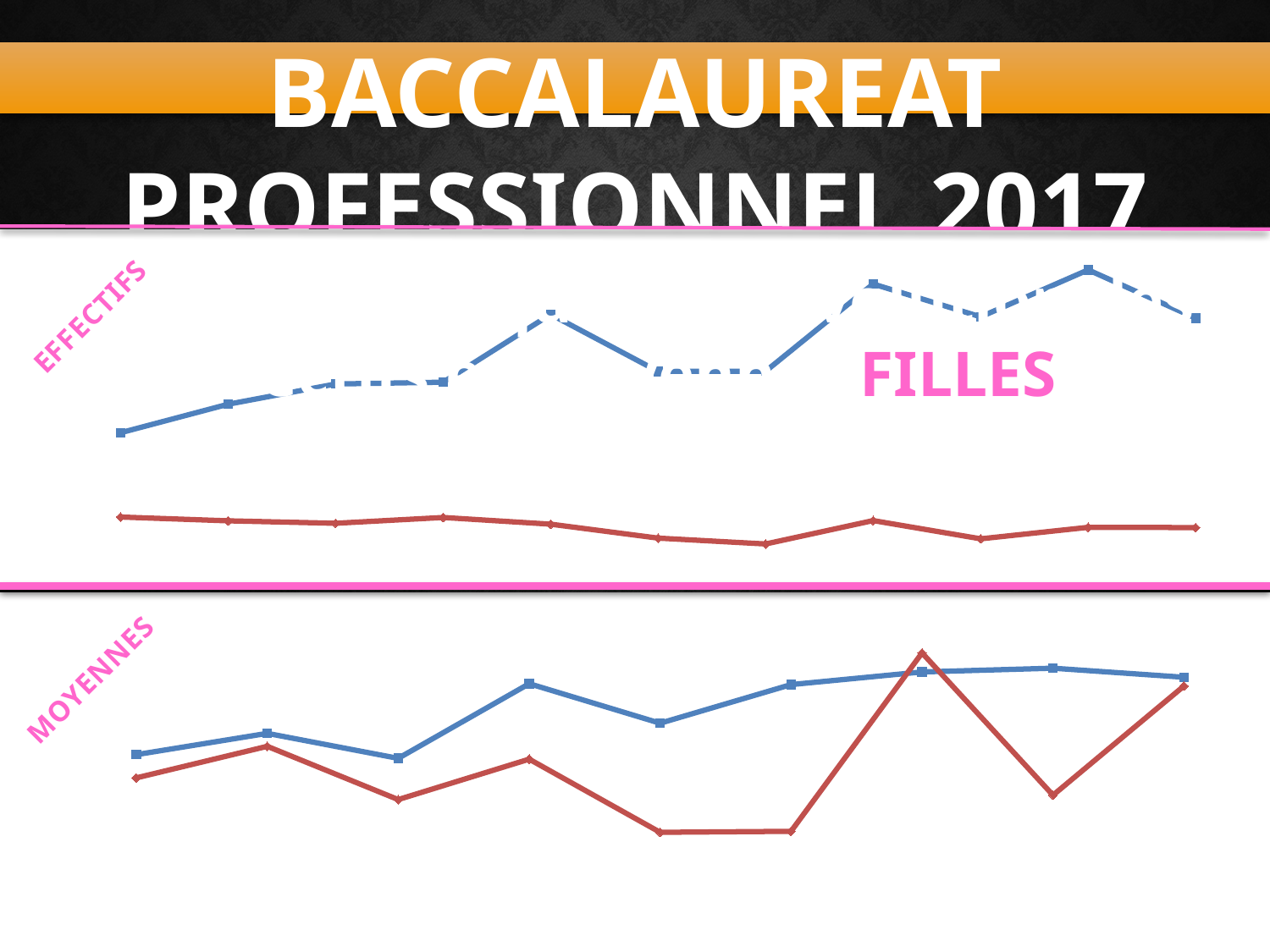
How many lines are plotted on the top chart labelled EFFECTIFS? 2 What word is written in pink inside the top chart? FILLES On the bottom chart labelled MOYENNES, which line is higher at the seventh point, the blue line or the red line? the red line What are the two colours of the lines on the bottom chart labelled MOYENNES? blue and red How many data points does the blue line on the bottom chart labelled MOYENNES have? 9 What kind of chart is the top chart labelled EFFECTIFS? line chart How many data points does the blue line on the top chart labelled EFFECTIFS have? 11 On the top chart labelled EFFECTIFS, which line is higher throughout, the blue line or the red line? the blue line On the bottom chart labelled MOYENNES, which line is higher at the first point, the blue line or the red line? the blue line What kind of chart is the bottom chart labelled MOYENNES? line chart On the top chart labelled EFFECTIFS, does the blue line overall rise or fall from left to right? rise